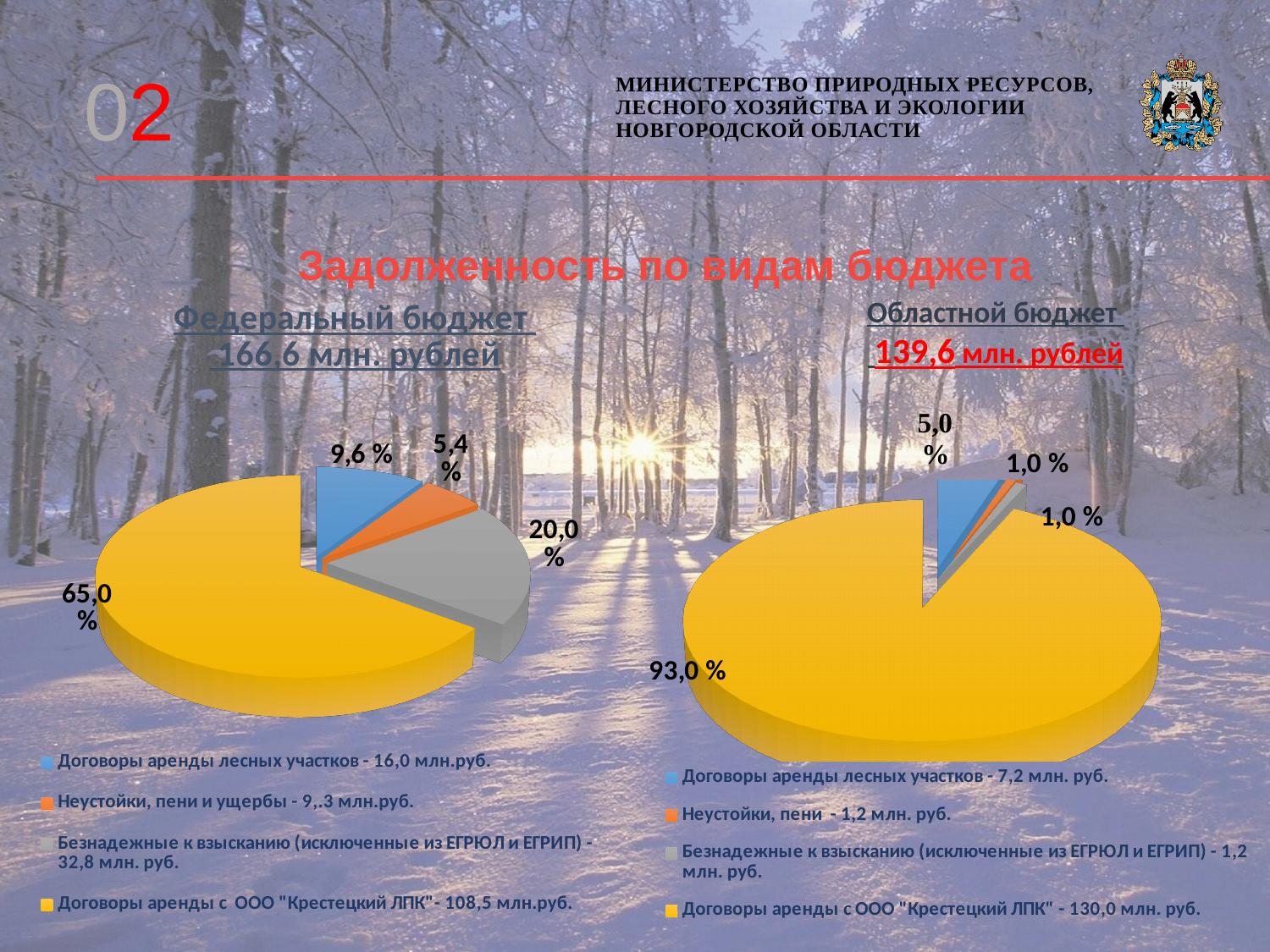
Which is larger: the share of Договоры аренды лесных участков on the left pie chart or on the right pie chart? Left pie chart (9,6 %) According to the legend of the right chart, what amount is given for Договоры аренды с ООО "Крестецкий ЛПК"? 130,0 млн. руб. What type of chart is used on this slide? Pie chart On the left pie chart (Федеральный бюджет), which category has the smallest share? Неустойки, пени и ущербы On the right pie chart (Областной бюджет), which category has the largest share? Договоры аренды с ООО "Крестецкий ЛПК" On the left pie chart (Федеральный бюджет), what share is shown for the yellow slice (Договоры аренды с ООО "Крестецкий ЛПК")? 65,0 % On the left pie chart (Федеральный бюджет), what is the difference between the shares of the yellow slice (65,0 %) and the grey slice (20,0 %)? 45,0 % How many slices does the left pie chart (Федеральный бюджет) have? 4 On the right pie chart (Областной бюджет), what share is shown for the yellow slice (Договоры аренды с ООО "Крестецкий ЛПК")? 93,0 % On the left pie chart (Федеральный бюджет), what share is shown for the blue slice (Договоры аренды лесных участков)? 9,6 % On the right pie chart (Областной бюджет), what share is shown for the blue slice (Договоры аренды лесных участков)? 5,0 % On the left pie chart (Федеральный бюджет), what share is shown for the grey slice (Безнадежные к взысканию)? 20,0 %